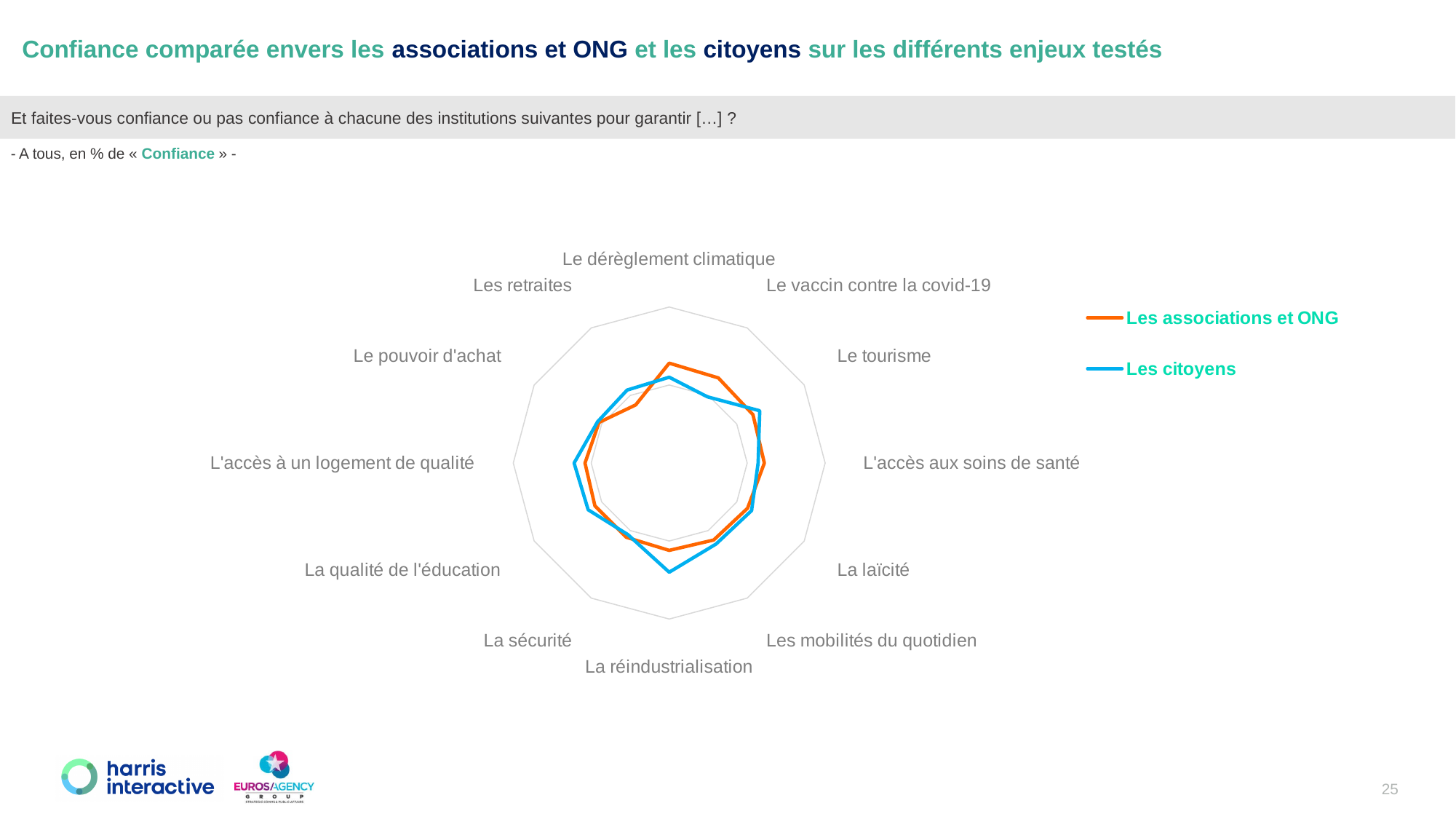
How many series does the legend list? 2 Which series is drawn in orange? Les associations et ONG For which issue does the 'Les citoyens' series reach its highest value? La réindustrialisation For 'Le dérèglement climatique', which series has the higher confidence value, Les associations et ONG or Les citoyens? Les associations et ONG What kind of chart is shown on the slide? Radar chart For 'Le vaccin contre la covid-19', which series has the higher confidence value, Les associations et ONG or Les citoyens? Les associations et ONG How many issues (categories) are plotted around the radar chart? 12 For 'La réindustrialisation', which series has the higher confidence value, Les associations et ONG or Les citoyens? Les citoyens Which series is drawn in blue? Les citoyens